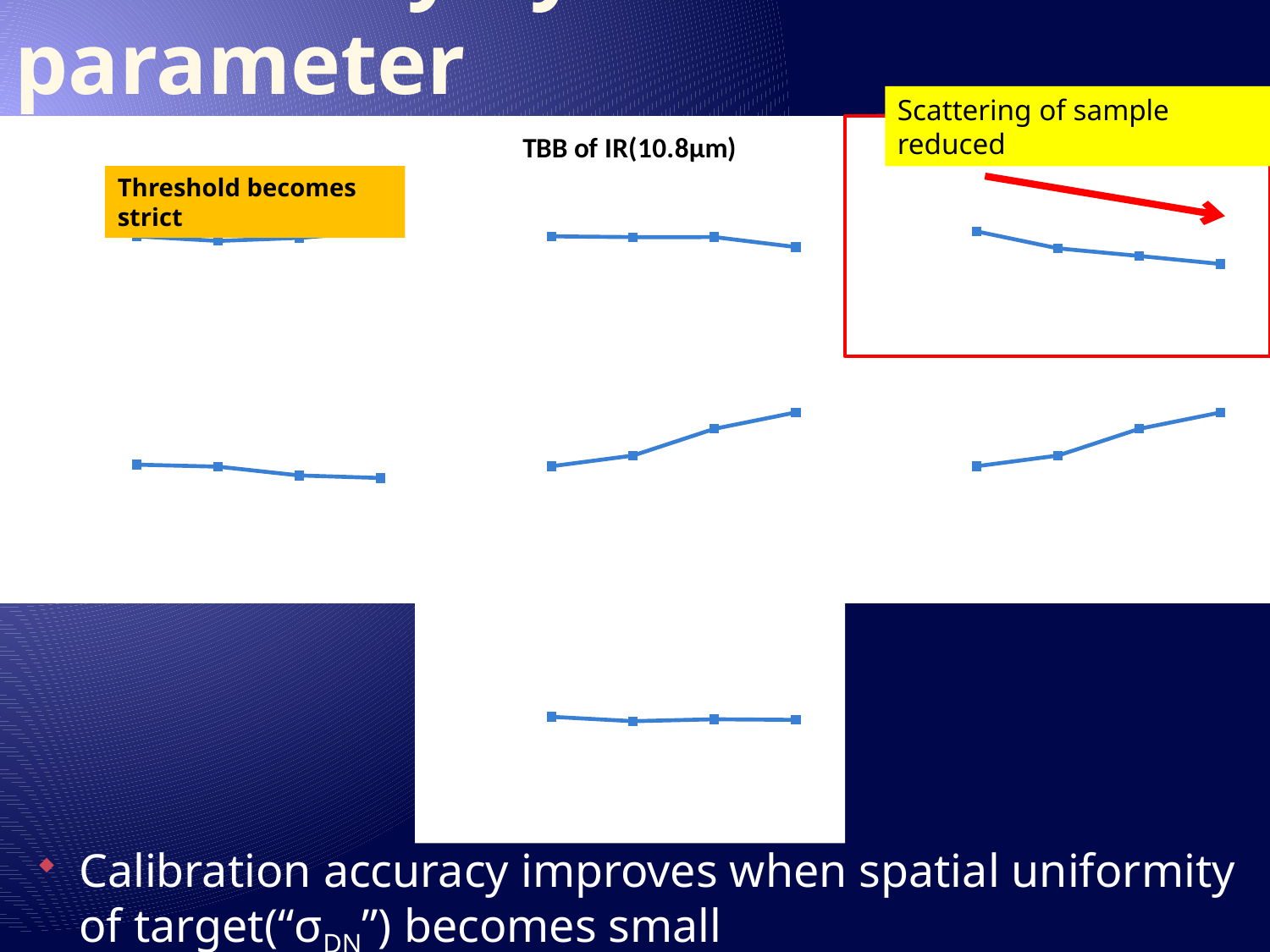
How many data points are plotted on the chart in the middle row, middle column of the slide? 4 What does the yellow annotation attached to the chart in the red box say? Scattering of sample reduced What kind of chart is the chart inside the red box at the top right of the slide? line chart What title is printed above the middle column of charts? TBB of IR(10.8μm) Do the values on the chart in the middle row, right column of the slide rise or fall from left to right? rise Do the values on the chart inside the red box at the top right of the slide rise or fall from left to right? fall How many data points are plotted on the chart inside the red box at the top right of the slide? 4 Do the values on the chart in the middle row, middle column of the slide rise or fall from left to right? rise What kind of chart is the chart at the bottom middle of the slide? line chart